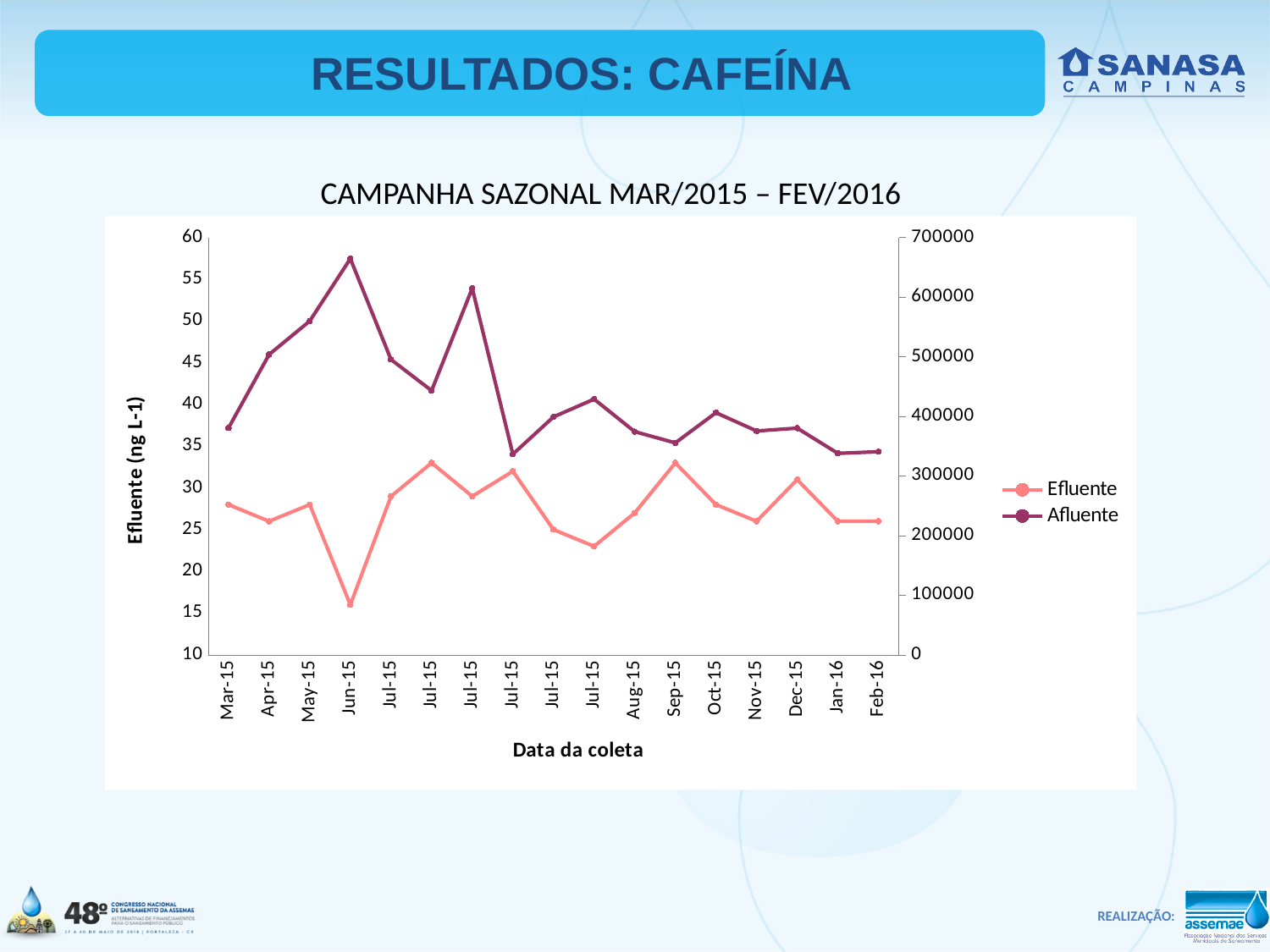
Is the Afluente value for Mar-15 greater or less than 400000? less Is the Afluente value for Jun-15 greater or less than 600000? greater What kind of chart is shown on the slide? line chart Is the Afluente value for May-15 greater or less than 500000? greater Does the Afluente series rise or fall from Mar-15 to Jun-15? rise At which collection date is the Efluente value lowest? Jun-15 How many series does the legend list? 2 What is the title of the chart? CAMPANHA SAZONAL MAR/2015 – FEV/2016 Which is larger, the Efluente value for Mar-15 or for Jun-15? Mar-15 At which collection date is the Afluente value highest? Jun-15 How many data points are plotted along the x axis for each series? 17